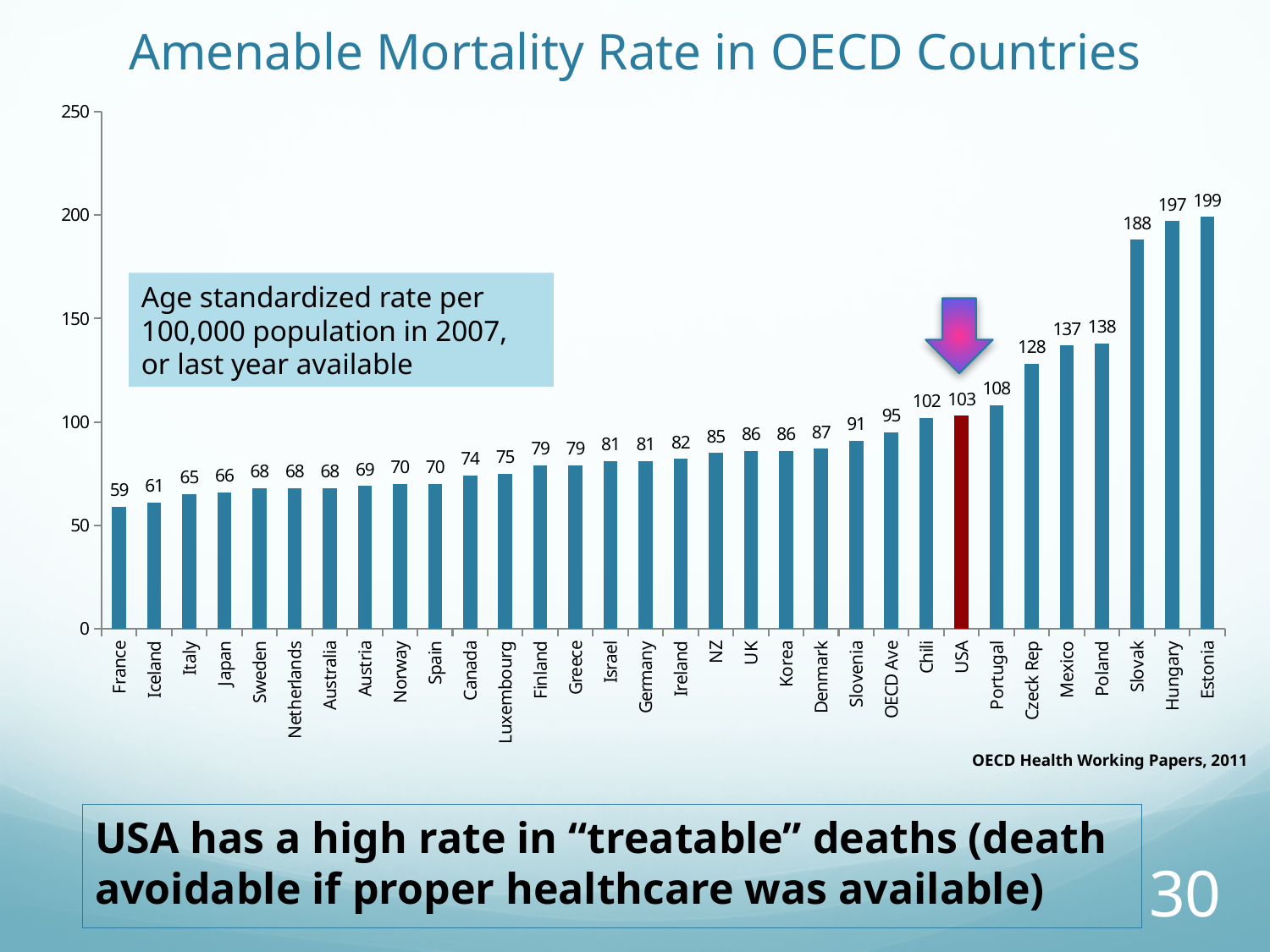
What kind of chart is shown on the slide? Bar chart Which bar is coloured red instead of blue? USA How much higher is the USA's rate than the OECD Ave? 8 Which country has the lowest amenable mortality rate on the chart? France How many bars (countries plus OECD Ave) are plotted on the chart? 32 What is the amenable mortality rate shown for the USA? 103 What is the value shown for Estonia? 199 Is the value for Slovak greater or less than 150? greater What is the difference between Estonia's and France's values? 140 Which country has the highest amenable mortality rate on the chart? Estonia What is the value shown for the OECD Ave bar? 95 Which has the larger value, Hungary or Slovak? Hungary